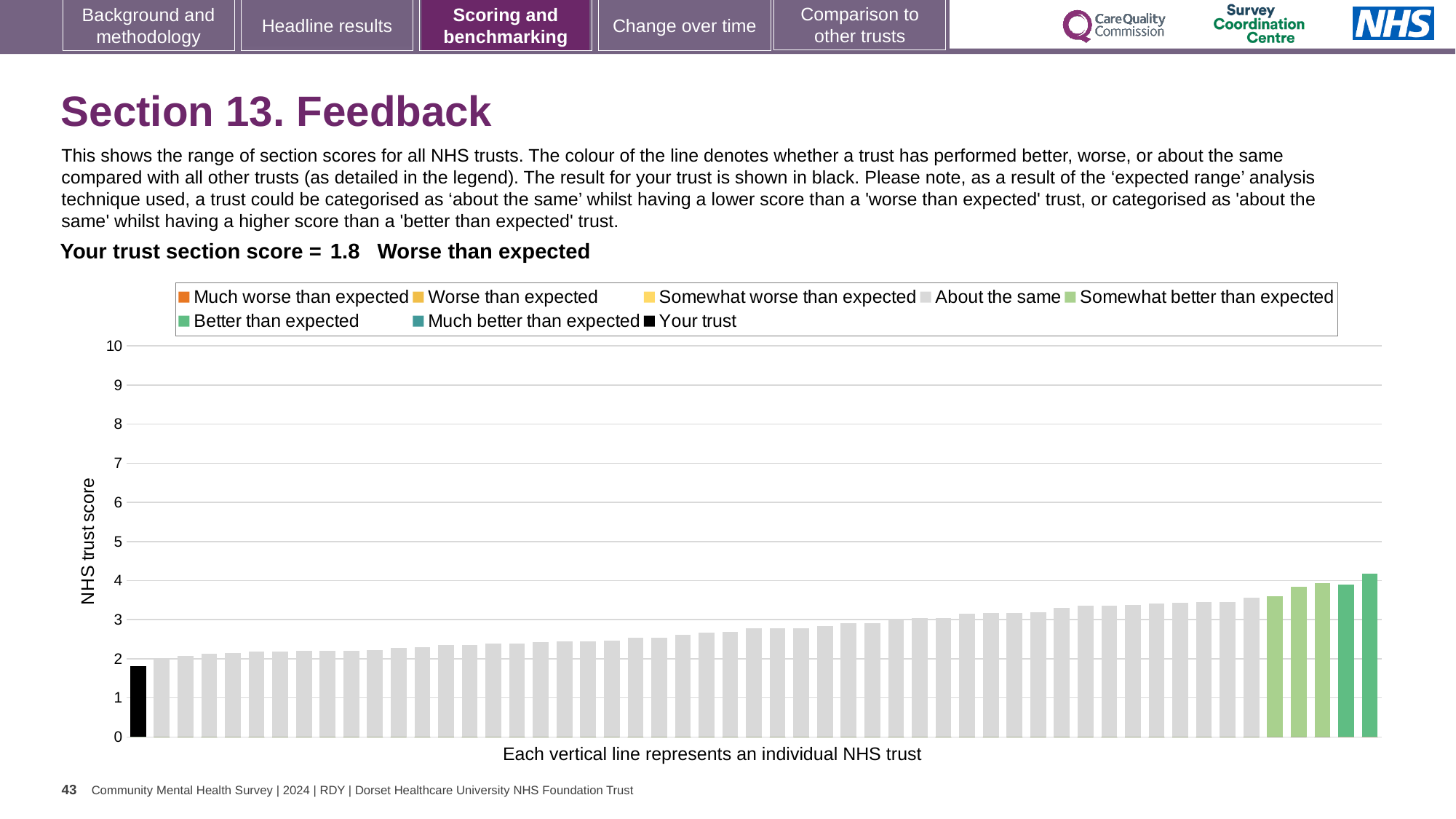
Is the value of the black 'Your trust' bar greater or less than 2? less What is the label on the y axis of the chart? NHS trust score Is the value of the tallest bar in the chart greater or less than 5? less Which bar is the lowest in the chart: the black 'Your trust' bar or one of the grey bars? the black 'Your trust' bar How many entries does the chart legend list? 8 What colour is the bar representing your trust? black Is the value of the tallest bar in the chart greater or less than 3? greater What is the section score for your trust shown on the slide? 1.8 What kind of chart is shown on the slide? bar chart Is the black 'Your trust' bar higher or lower than the rightmost green bar? lower Do the bar values rise or fall moving from left to right along the x axis? rise